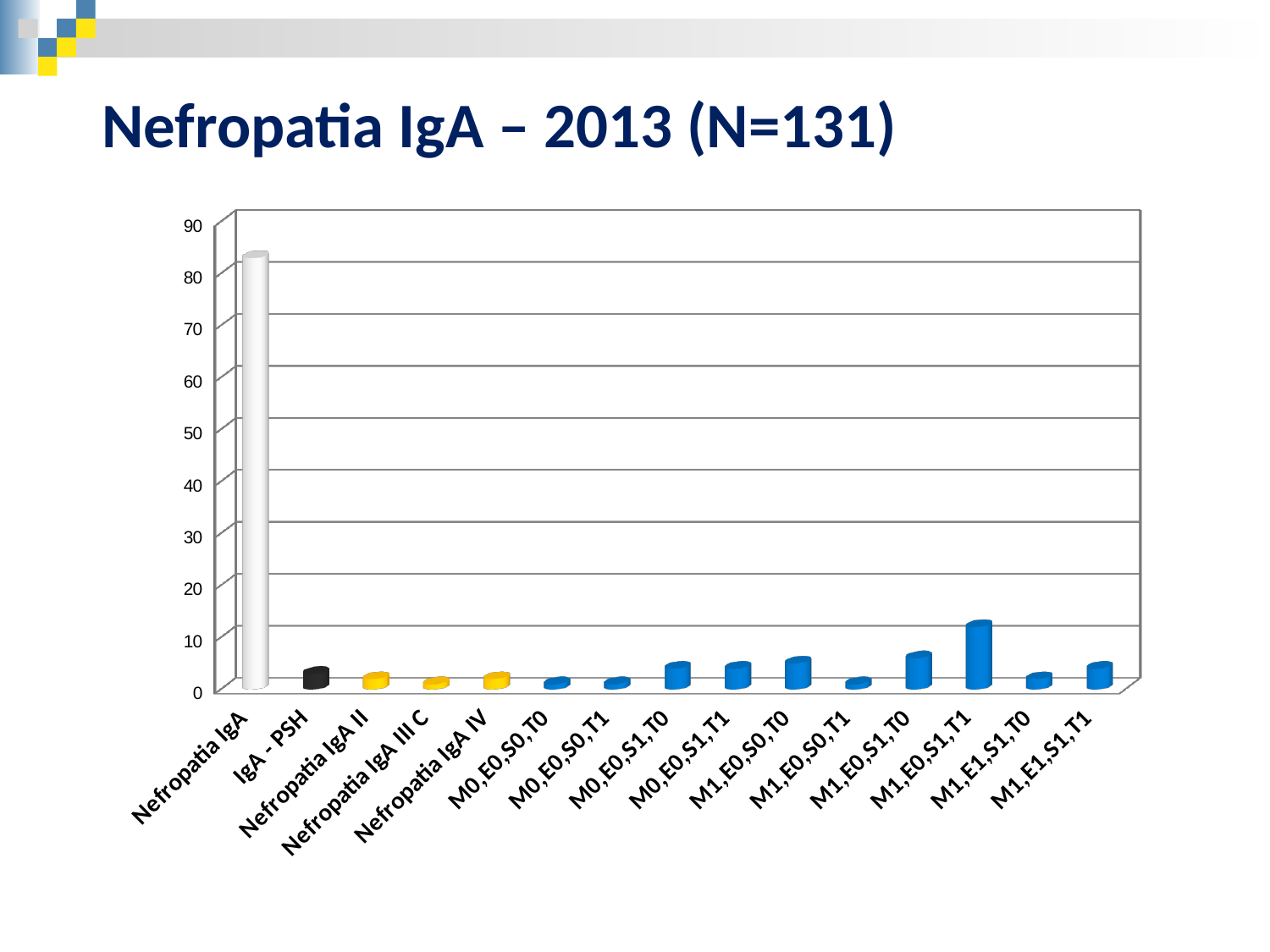
Which is larger, the value for Nefropatia IgA or the value for IgA - PSH? Nefropatia IgA Which of the blue bars (the M/E/S/T categories) is the highest? M1,E0,S1,T1 Which category has the highest bar in the chart? Nefropatia IgA How many categories are shown on the x axis of the chart? 15 Is the value for M1,E0,S1,T1 greater or less than 20? less Is the value for IgA - PSH greater or less than 10? less What kind of chart is shown on the slide? Bar chart Which is larger, the value for M1,E0,S1,T1 or the value for M1,E0,S1,T0? M1,E0,S1,T1 Which is larger, the value for M1,E0,S0,T0 or the value for M1,E0,S0,T1? M1,E0,S0,T0 Is the value for Nefropatia IgA greater or less than 70? greater What is the title of the chart on the slide? Nefropatia IgA – 2013 (N=131) What colour is the bar for IgA - PSH? Black